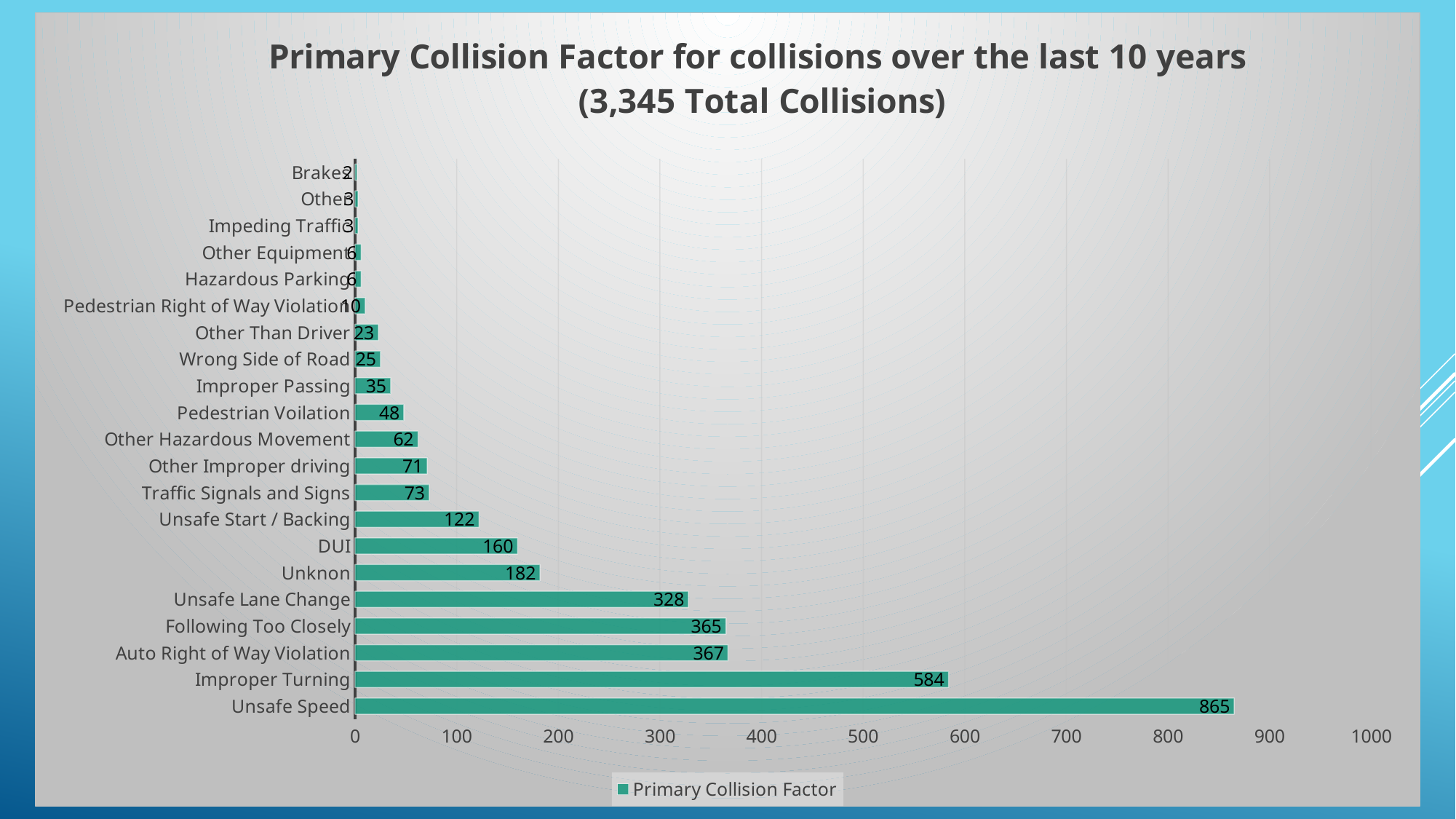
Which primary collision factor has the highest number of collisions? Unsafe Speed How many primary collision factor categories are plotted on the chart? 21 How many collisions are attributed to Unsafe Speed? 865 What is the value for DUI? 160 What type of chart is shown on the slide? bar chart Which primary collision factor has the lowest number of collisions? Brakes What is the value for Unsafe Lane Change? 328 Which is larger, the value for Unsafe Lane Change or the value for Unknon? Unsafe Lane Change What is the difference between the values for Unsafe Speed and Improper Turning? 281 How many series does the legend list? 1 What is the value for Improper Turning? 584 What total number of collisions is stated in the chart title? 3,345